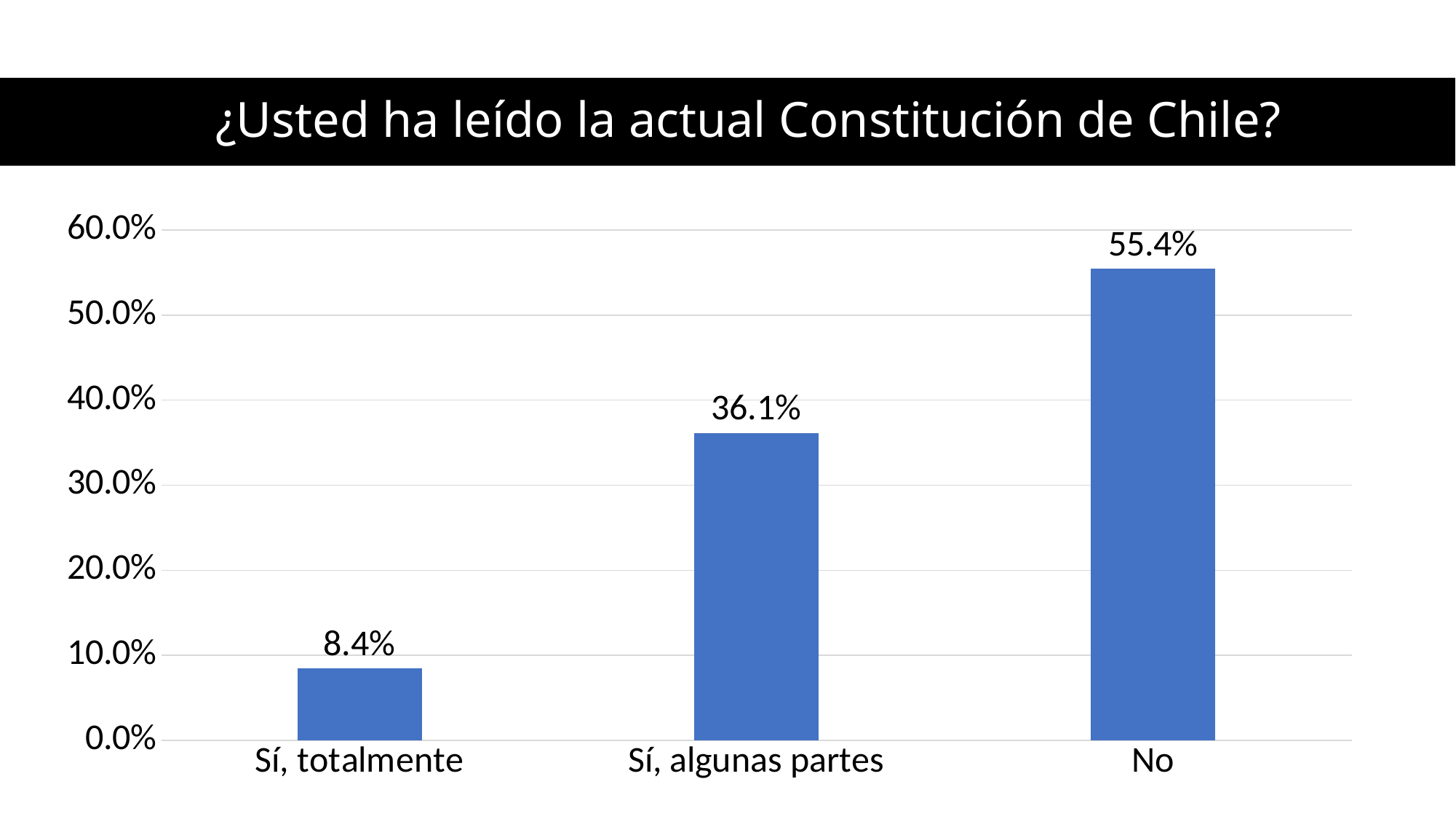
Which category has the lowest value? Sí, totalmente What is the difference between the values for "Sí, algunas partes" and "Sí, totalmente"? 27.7% Which is larger, the value for "Sí, totalmente" or the value for "Sí, algunas partes"? Sí, algunas partes What is the value for "No"? 55.4% How many categories are shown on the chart? 3 What is the value for "Sí, totalmente"? 8.4% What is the difference between the values for "No" and "Sí, algunas partes"? 19.3% What is the title of the chart? ¿Usted ha leído la actual Constitución de Chile? Is the value for "No" greater or less than 50.0%? greater What kind of chart is shown on the slide? Bar chart Which category has the highest value? No What is the value for "Sí, algunas partes"? 36.1%